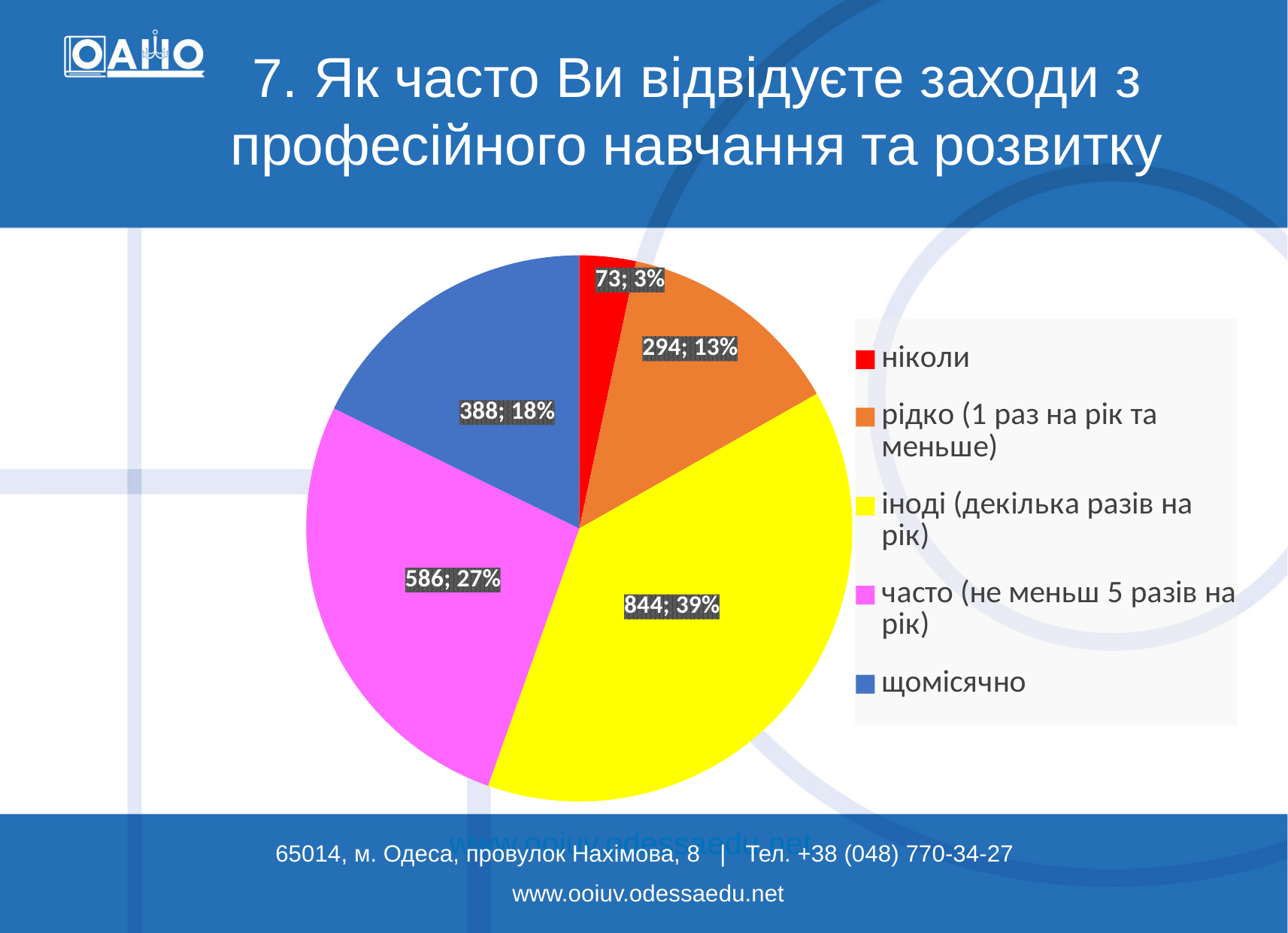
What is the count for the "щомісячно" slice? 388 How many slices does the pie chart have? 5 What is the difference between the counts for "іноді (декілька разів на рік)" and "часто (не меньш 5 разів на рік)"? 258 What is the count for the "ніколи" slice? 73 What kind of chart is shown on the slide? pie chart Which is larger, the count for "щомісячно" or the count for "рідко (1 раз на рік та меньше)"? щомісячно What share of the pie does "часто (не меньш 5 разів на рік)" take? 27% Which category has the smallest slice? ніколи What is the count for the "іноді (декілька разів на рік)" slice? 844 What share of the pie does "рідко (1 раз на рік та меньше)" take? 13% What colour is the "ніколи" slice? red Which category has the largest slice? іноді (декілька разів на рік)